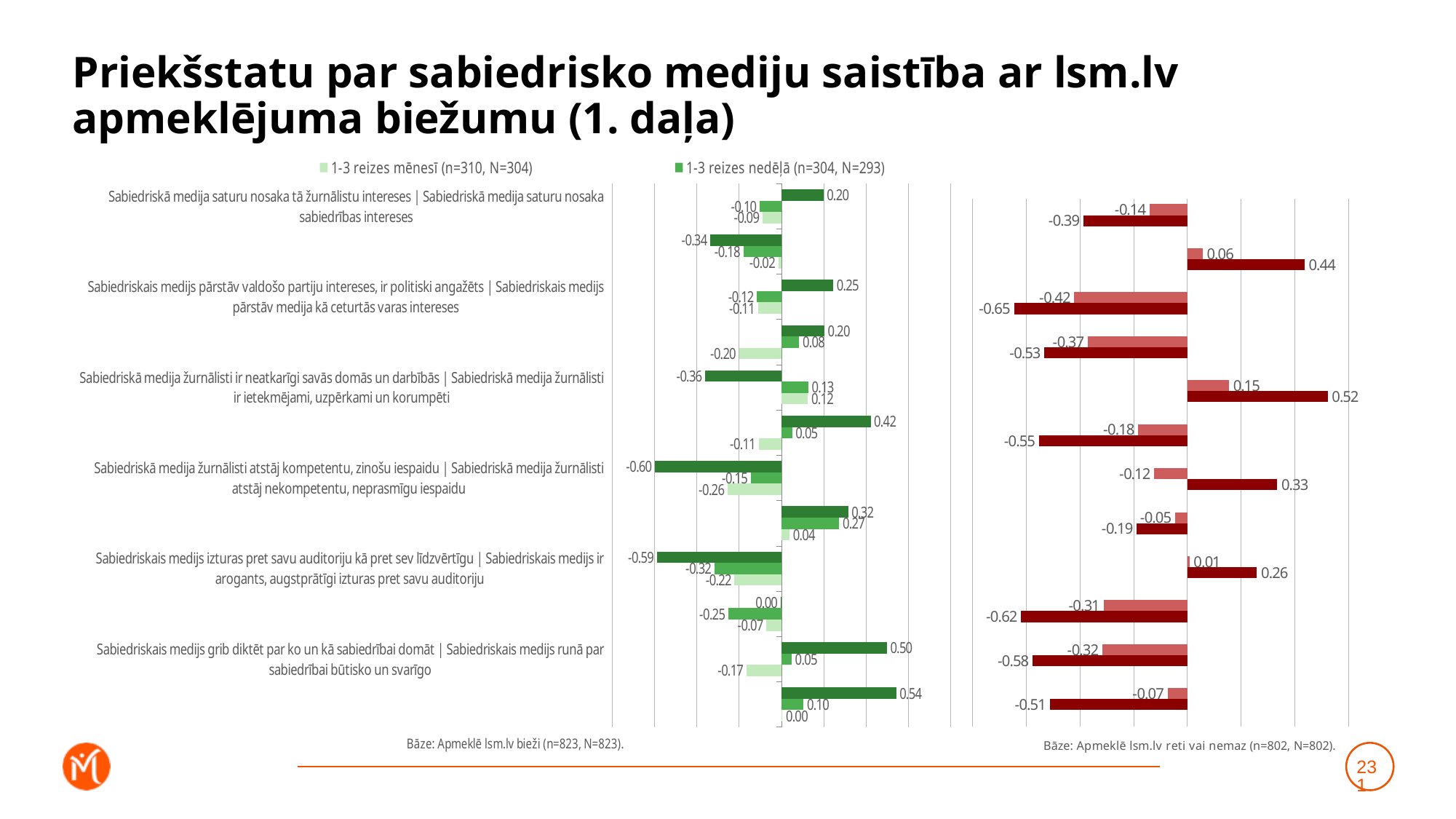
In the left (green) chart, which is larger: the highest value 0.54 or the value 0.50 in the group just above it? 0.54 What base note is printed under the left (green) chart? Bāze: Apmeklē lsm.lv bieži (n=823, N=823). In the left (green) chart, what is the value of the topmost dark green bar? 0.20 In the right (red) chart, what is the value of the topmost dark red bar? -0.39 What kind of chart is shown on the left side of the slide? bar chart What is the first legend entry (light green) at the top of the slide? 1-3 reizes mēnesī (n=310, N=304) In the right (red) chart, what is the lowest value shown? -0.65 How many series does the legend at the top of the slide list? 2 In the right (red) chart, what is the difference between the highest value (0.52) and the lowest value (-0.65)? 1.17 In the left (green) chart, what is the lowest value shown? -0.60 In the right (red) chart, what is the highest value shown? 0.52 In the left (green) chart, what is the highest value shown? 0.54